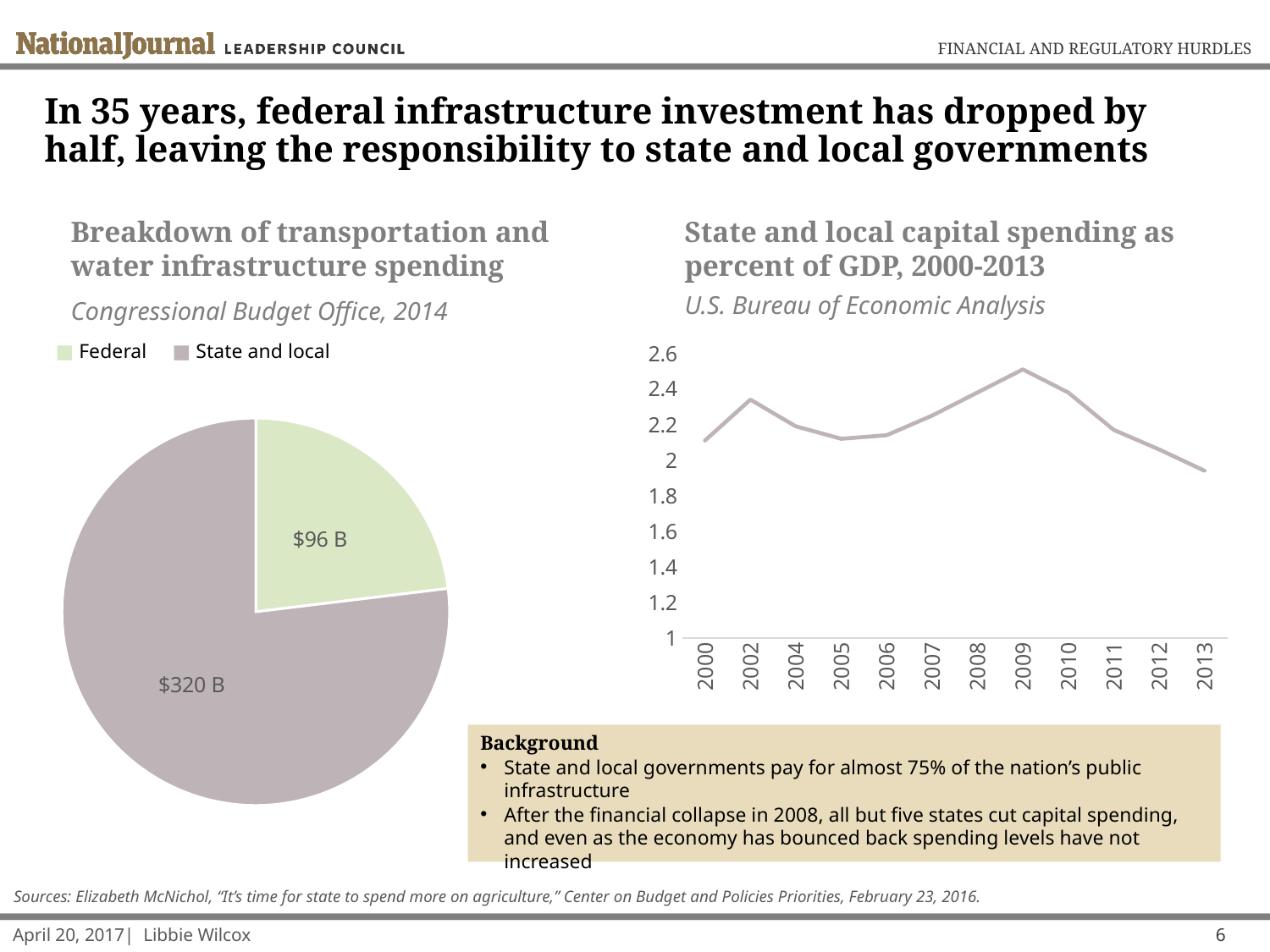
In the pie chart on the left, what is the value for Federal spending? $96 B How many series does the legend of the pie chart on the left list? 2 In the 'State and local capital spending as percent of GDP' chart, is the value for 2013 greater or less than 2? less What kind of chart is the chart on the left of the slide? Pie chart In the 'State and local capital spending as percent of GDP' chart, which year has the highest value? 2009 In the pie chart on the left, what is the value for State and local spending? $320 B In the pie chart on the left, what is the difference between State and local spending and Federal spending? $224 B In the 'State and local capital spending as percent of GDP' chart, is the value for 2009 greater or less than 2.4? greater What kind of chart is the 'State and local capital spending as percent of GDP, 2000-2013' chart? Line chart In the pie chart on the left, what is the total of the two slices? $416 B In the pie chart on the left, which category is larger, Federal or State and local? State and local In the 'State and local capital spending as percent of GDP' chart, do values rise or fall from 2009 to 2013? fall